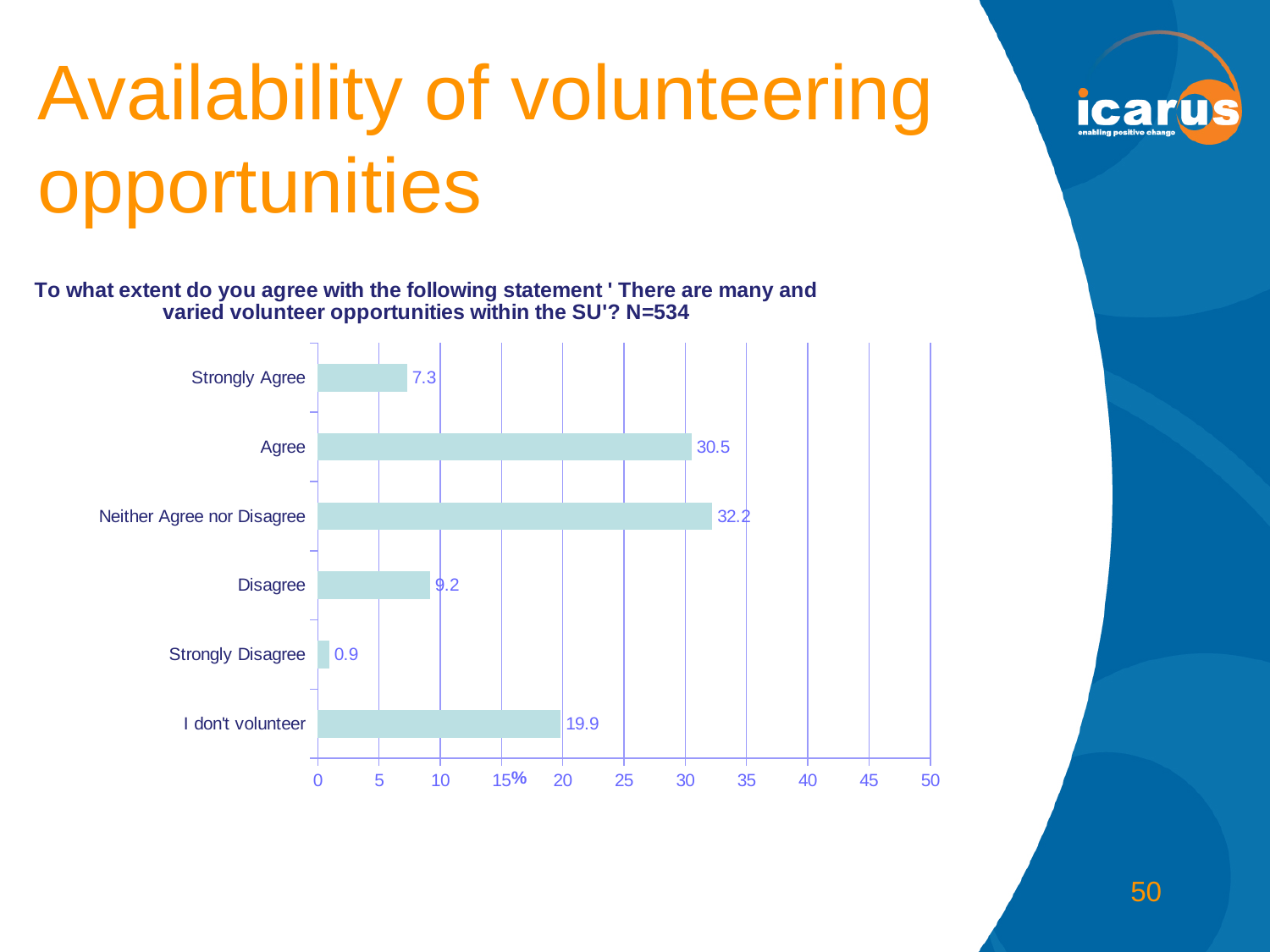
What is the value for Agree? 30.5 What is the value for I don't volunteer? 19.9 What is the difference between the values for I don't volunteer and Disagree? 10.7 What kind of chart is shown on the slide? bar chart Is the value for Agree greater or less than 25? greater What sample size (N) is stated in the chart title? 534 What is the difference between the values for Neither Agree nor Disagree and Agree? 1.7 What is the value for Strongly Disagree? 0.9 Which is larger, the value for Disagree or the value for Strongly Agree? Disagree Which category has the highest value? Neither Agree nor Disagree How many categories are shown on the chart? 6 Which category has the lowest value? Strongly Disagree